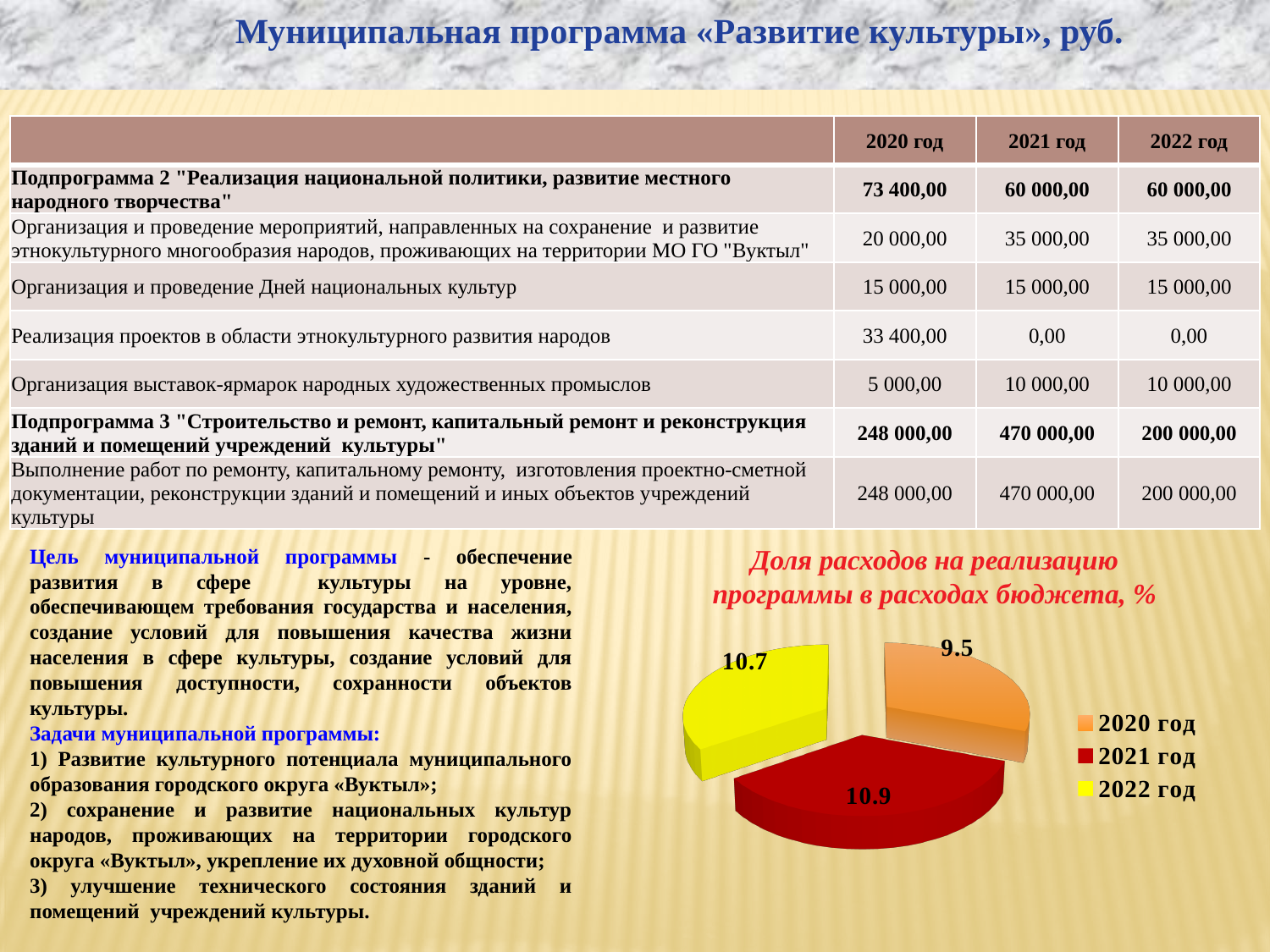
Which year has the largest value in the pie chart? 2021 год What type of chart is shown on the slide? Pie chart What is the title of the pie chart? Доля расходов на реализацию программы в расходах бюджета, % How many entries does the legend of the pie chart list? 3 What value is shown for 2021 год in the pie chart? 10.9 What value is shown for 2020 год in the pie chart? 9.5 Which year has the smallest value in the pie chart? 2020 год In the pie chart, which is larger: the value for 2021 год or the value for 2022 год? 2021 год How many slices does the pie chart have? 3 What is the difference between the values for 2021 год and 2020 год in the pie chart? 1.4 What value is shown for 2022 год in the pie chart? 10.7 What is the difference between the values for 2022 год and 2020 год in the pie chart? 1.2